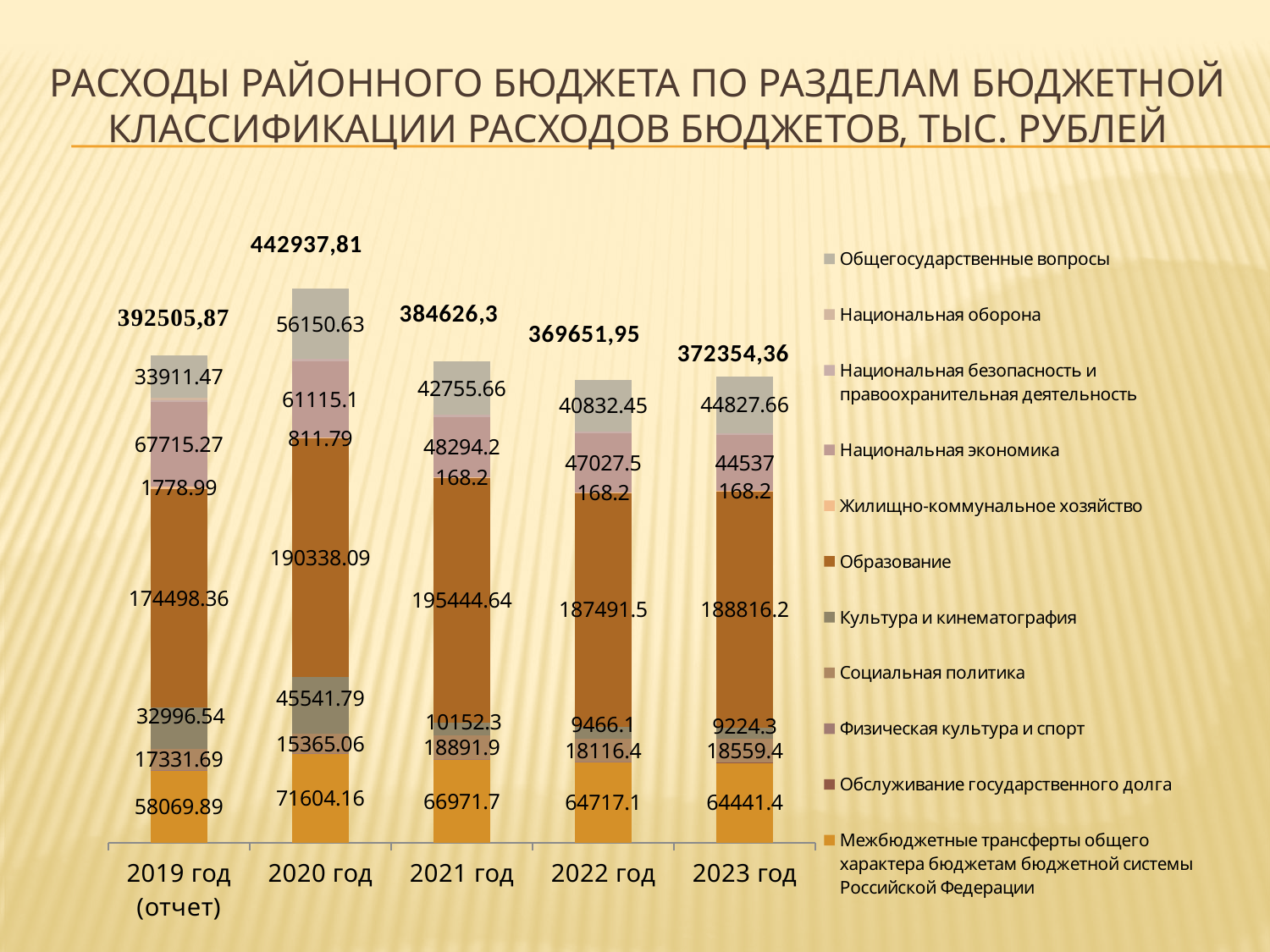
In what units are the values on the slide expressed, according to the title? тыс. рублей Which year has the highest total expenditure? 2020 год What is the value of the top segment (Общегосударственные вопросы) for 2020 год? 56150.63 What is the value of Образование for 2021 год? 195444.64 Which year has the larger value for Образование: 2019 год (отчет) or 2020 год? 2020 год What kind of chart is shown on the slide? Stacked bar chart How many series does the chart's legend list? 11 What is the total of the stacked bar for 2020 год? 442937,81 Which year has the lowest total expenditure? 2022 год What is the difference between the Образование values for 2021 год and 2019 год (отчет)? 20946.28 What is the value of the bottom segment (Межбюджетные трансферты общего характера) for 2019 год (отчет)? 58069.89 How many years (categories) are shown on the x axis of the chart? 5